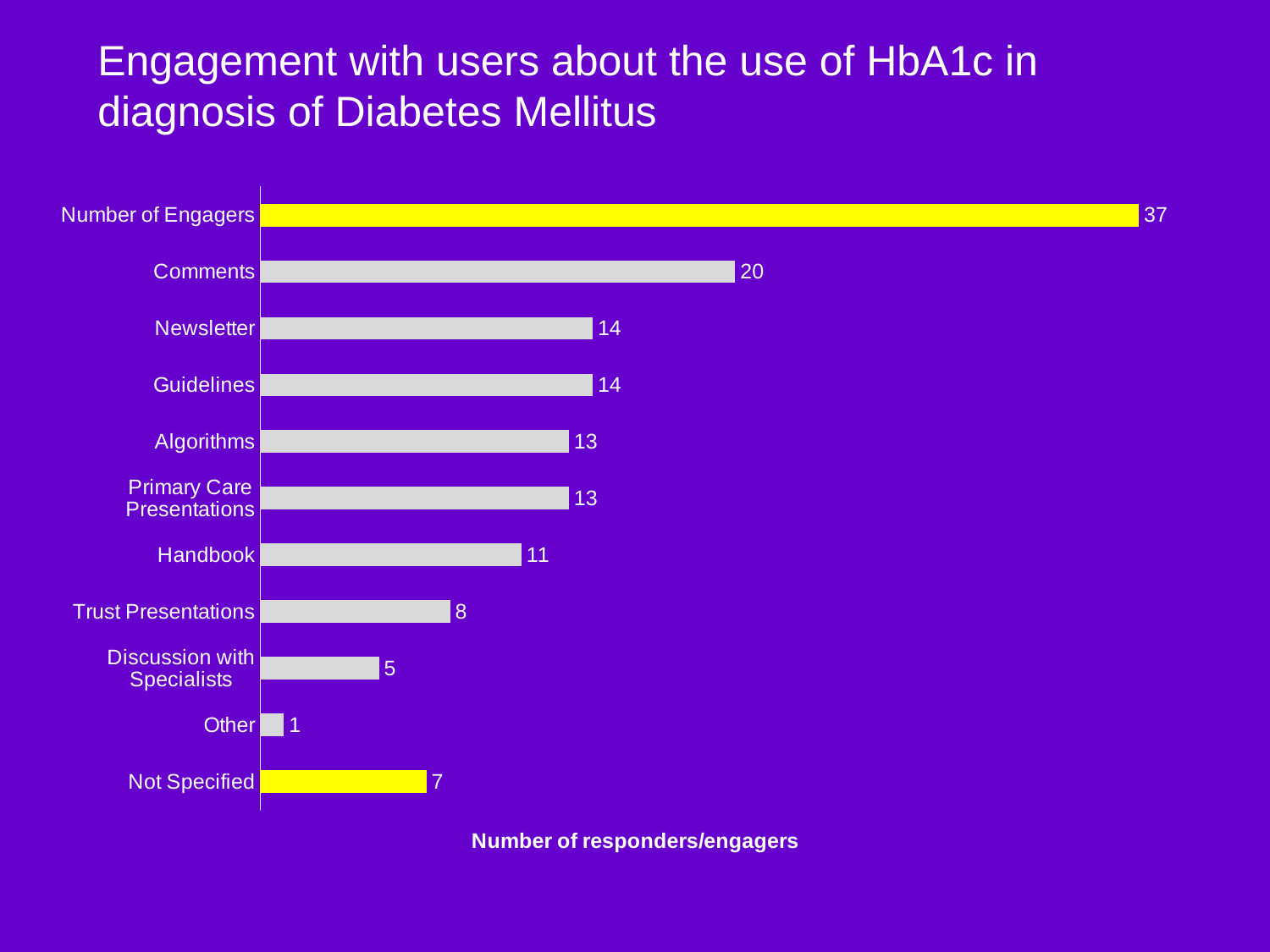
What is the x-axis title of the chart? Number of responders/engagers Which is larger, the value for Newsletter or the value for Handbook? Newsletter What kind of chart is shown on the slide? Bar chart How many categories are shown in the chart? 11 What is the difference between the values for Number of Engagers and Comments? 17 What is the value for Not Specified? 7 Which category has the lowest value? Other What is the value for Comments? 20 What is the value for Handbook? 11 What is the difference between the values for Trust Presentations and Discussion with Specialists? 3 Which category has the highest value? Number of Engagers What is the value for Discussion with Specialists? 5